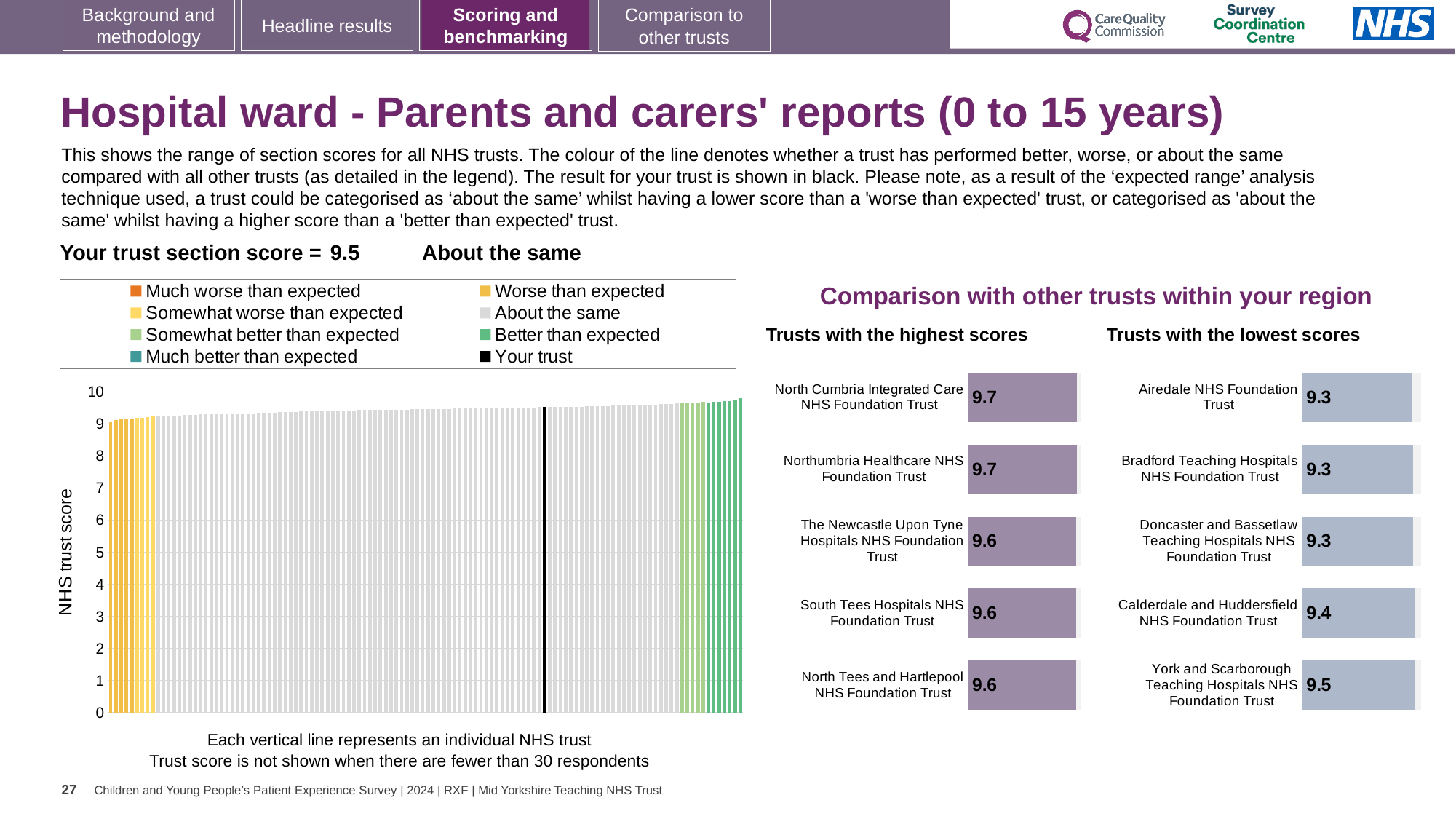
In the 'Trusts with the lowest scores' chart, what is the score for Calderdale and Huddersfield NHS Foundation Trust? 9.4 How many trusts are shown in the 'Trusts with the highest scores' chart? 5 What is the difference between the score for North Cumbria Integrated Care NHS Foundation Trust in the 'Trusts with the highest scores' chart and the score for Airedale NHS Foundation Trust in the 'Trusts with the lowest scores' chart? 0.4 In the large chart on the left, is the value for your trust (the black line) greater or less than 9? greater How many entries does the legend above the large chart on the left list? 8 In the 'Trusts with the highest scores' chart, what is the score for North Cumbria Integrated Care NHS Foundation Trust? 9.7 What is the y-axis label of the large chart on the left? NHS trust score What is the section score for your trust shown on the slide? 9.5 What kind of chart is the large chart on the left showing NHS trust scores? bar chart In the 'Trusts with the lowest scores' chart, which trust has the highest score? York and Scarborough Teaching Hospitals NHS Foundation Trust In the 'Trusts with the lowest scores' chart, which has the larger score: Calderdale and Huddersfield NHS Foundation Trust or York and Scarborough Teaching Hospitals NHS Foundation Trust? York and Scarborough Teaching Hospitals NHS Foundation Trust In the 'Trusts with the highest scores' chart, what is the score for South Tees Hospitals NHS Foundation Trust? 9.6